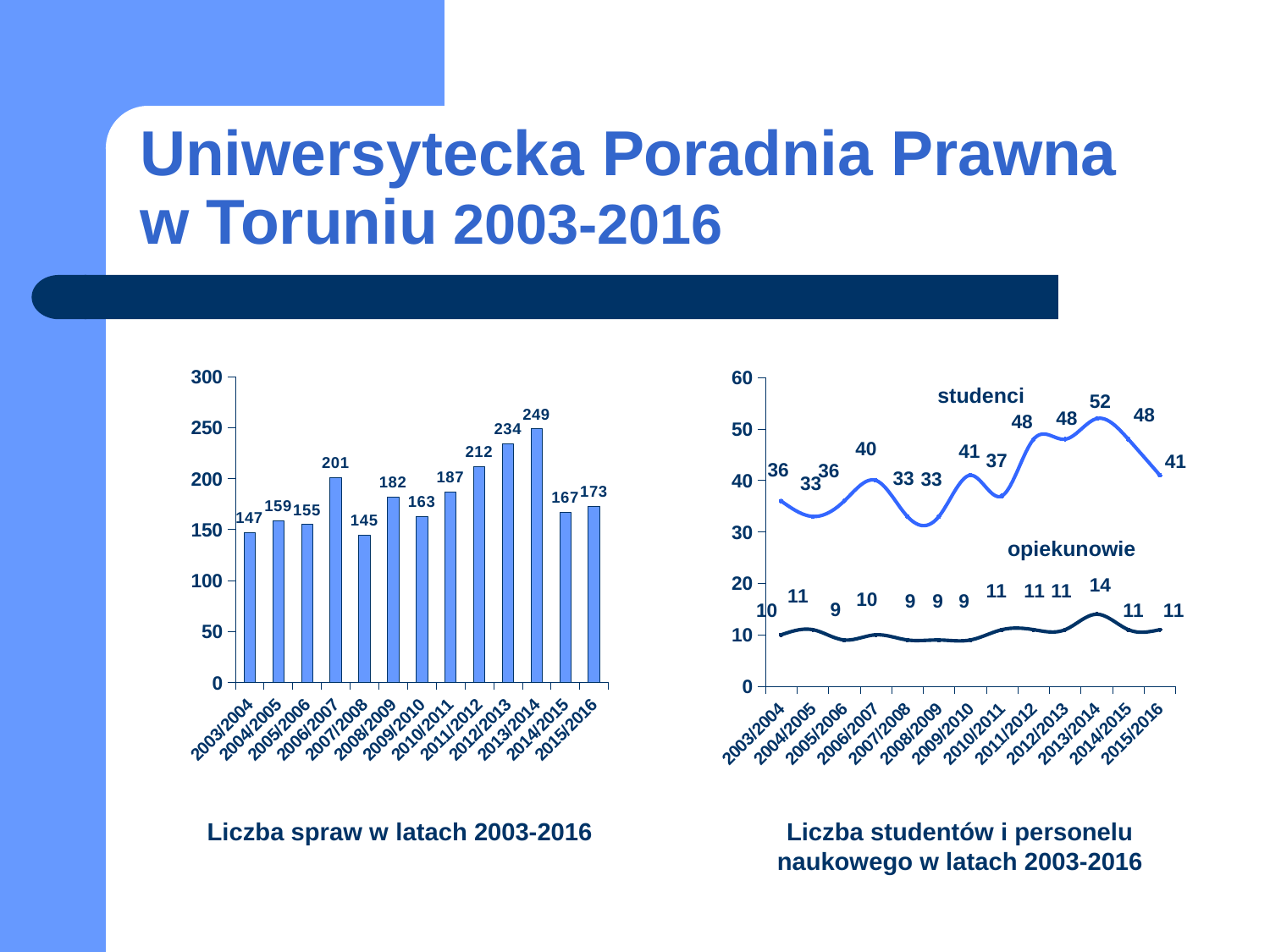
In the chart titled 'Liczba studentów i personelu naukowego w latach 2003-2016', what is the value for studenci in 2013/2014? 52 In the chart titled 'Liczba spraw w latach 2003-2016', what is the difference between the values for 2013/2014 and 2014/2015? 82 In the chart titled 'Liczba spraw w latach 2003-2016', how many years are shown on the x axis? 13 In the chart titled 'Liczba studentów i personelu naukowego w latach 2003-2016', what is the value for opiekunowie in 2015/2016? 11 In the chart titled 'Liczba studentów i personelu naukowego w latach 2003-2016', in which year does opiekunowie reach its highest value? 2013/2014 In the chart titled 'Liczba studentów i personelu naukowego w latach 2003-2016', what is the difference between studenci and opiekunowie in 2015/2016? 30 What kind of chart is the chart titled 'Liczba studentów i personelu naukowego w latach 2003-2016'? line chart What kind of chart is the chart titled 'Liczba spraw w latach 2003-2016'? bar chart In the chart titled 'Liczba spraw w latach 2003-2016', which year has the lowest value? 2007/2008 In the chart titled 'Liczba spraw w latach 2003-2016', which year has the highest value? 2013/2014 In the chart titled 'Liczba spraw w latach 2003-2016', which is larger, the value for 2008/2009 or the value for 2009/2010? 2008/2009 In the chart titled 'Liczba spraw w latach 2003-2016', what is the value for 2006/2007? 201